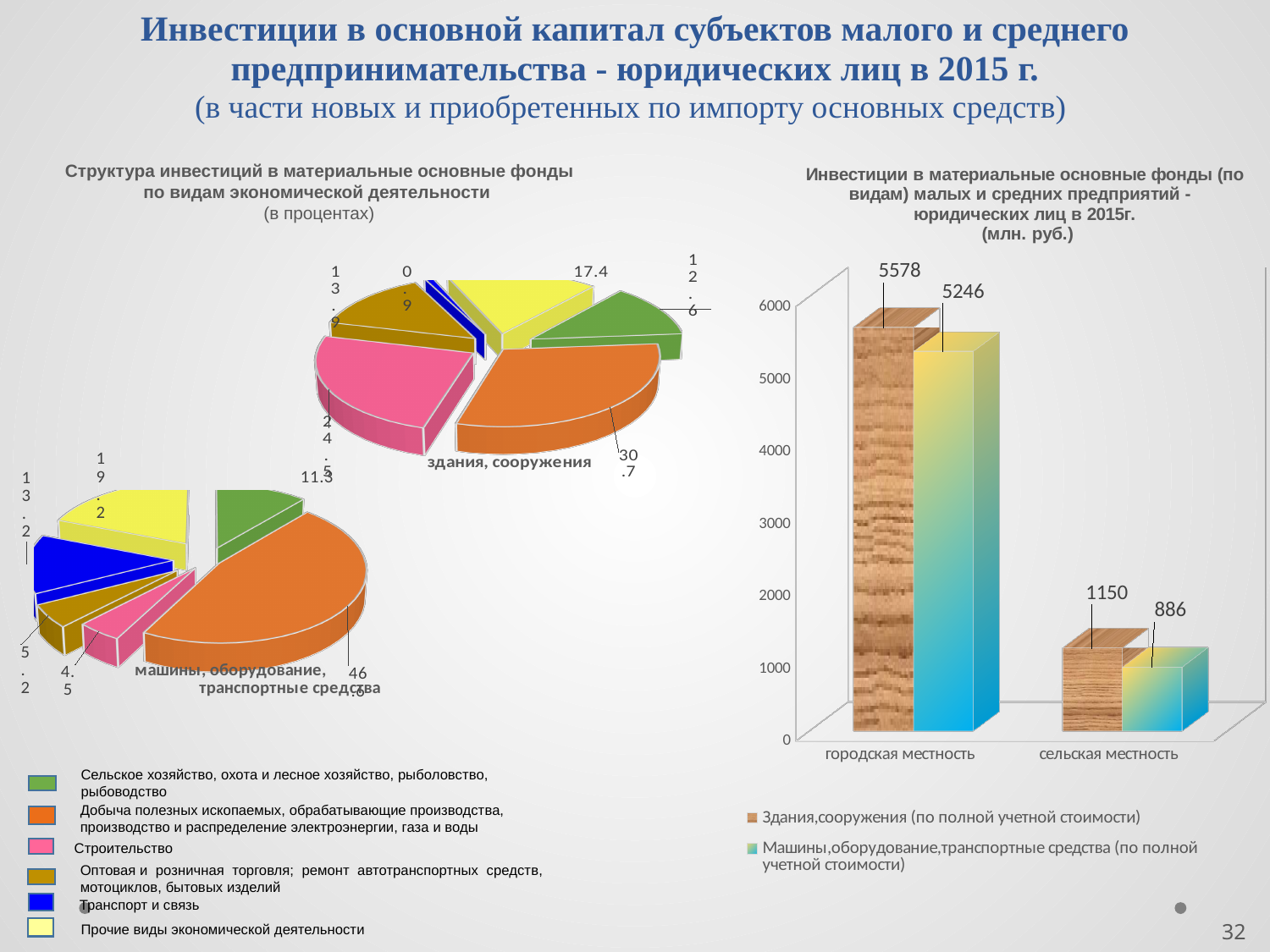
In the bar chart on the right, which category has the highest value for Здания,сооружения? городская местность In the pie chart labelled машины, оборудование, транспортные средства, which slice is the largest? Добыча полезных ископаемых, обрабатывающие производства, производство и распределение электроэнергии, газа и воды In the pie chart labelled здания, сооружения, which slice is the smallest? Транспорт и связь In the bar chart on the right, how many series does the legend list? 2 What kind of chart is the chart on the right of the slide? bar chart In the bar chart on the right, what is the value for Машины,оборудование,транспортные средства in сельская местность? 886 In the bar chart on the right, what is the difference between Здания,сооружения and Машины,оборудование,транспортные средства in городская местность? 332 In the bar chart on the right, is the value for Машины,оборудование,транспортные средства in городская местность greater or less than 5000? greater In the bar chart on the right, what is the value for Здания,сооружения in городская местность? 5578 In the pie chart labelled здания, сооружения, what share does the largest slice (Добыча полезных ископаемых, обрабатывающие производства...) have? 30.7 In the pie chart labelled машины, оборудование, транспортные средства, what share does Строительство have? 4.5 In the bar chart on the right, what is the value for Здания,сооружения in сельская местность? 1150